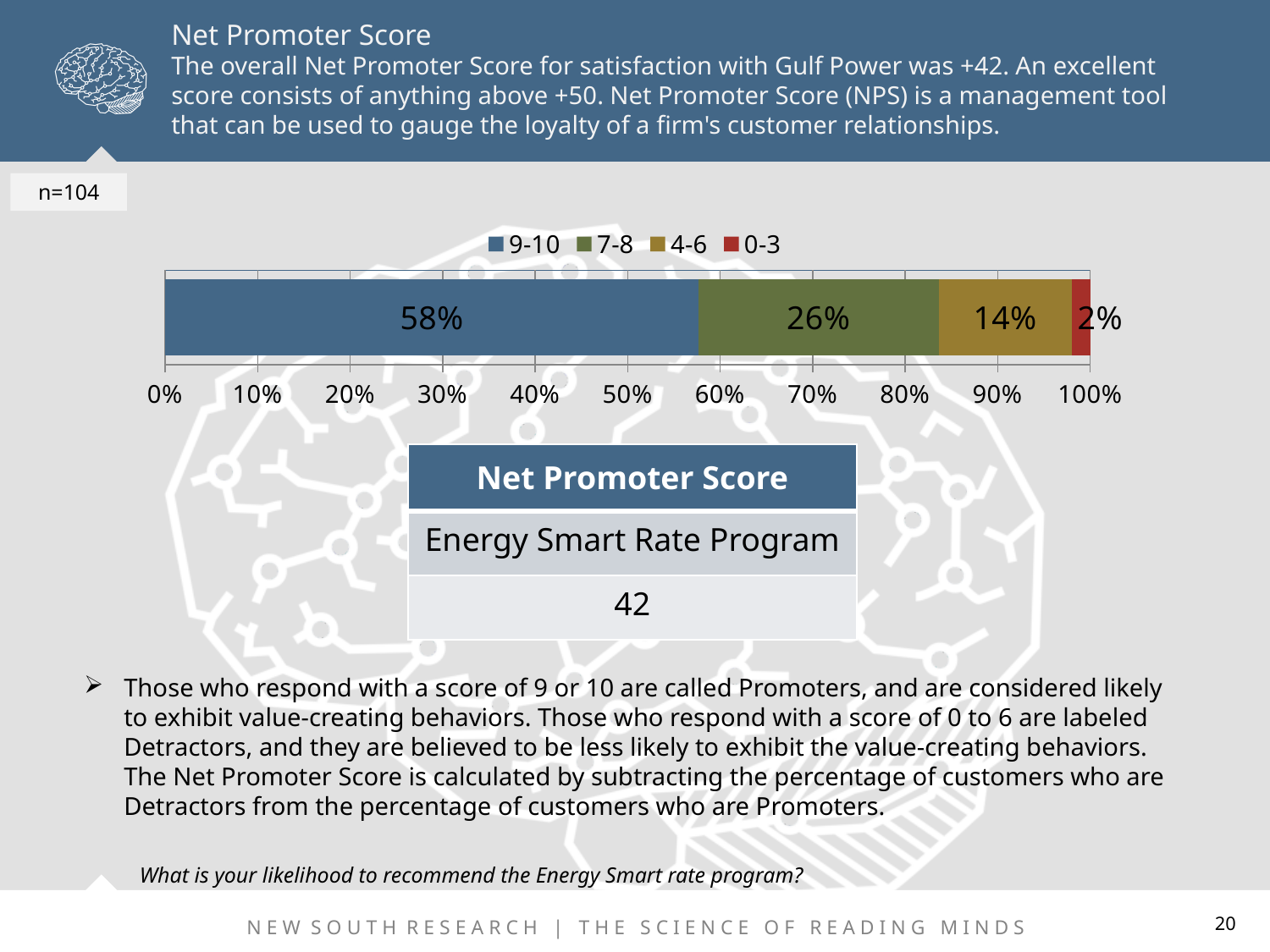
How many series does the legend list? 4 What colour is the 0-3 segment in the chart? Red What is the total of all segments in the stacked bar? 100% What is the difference in percentage points between the 9-10 group and the 7-8 group? 32 What percentage of respondents gave a score of 4-6? 14% Which score group has the largest share of respondents? 9-10 Which is larger, the share for 7-8 or the share for 4-6? 7-8 What percentage of respondents gave a score of 0-3? 2% What percentage of respondents gave a score of 7-8? 26% What kind of chart is shown on the slide? Stacked bar chart What percentage of respondents gave a score of 9-10? 58% Which score group has the smallest share of respondents? 0-3